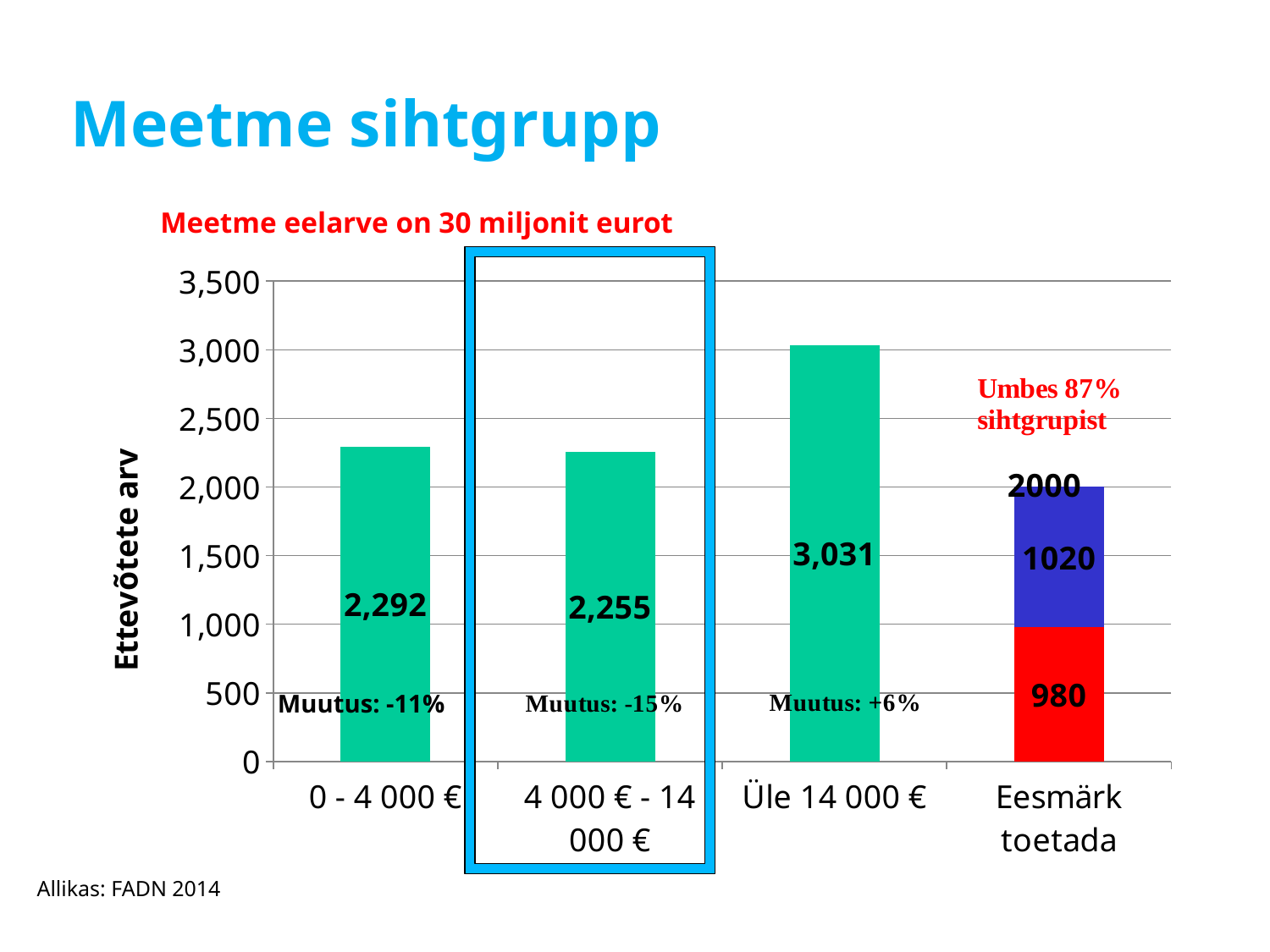
Which is larger, the value for "Üle 14 000 €" or the value for "4 000 € - 14 000 €"? Üle 14 000 € What is the total of the stacked "Eesmärk toetada" bar? 2000 What kind of chart is shown on the slide? Bar chart What is the value for the "Üle 14 000 €" category? 3,031 What is the value for the "0 - 4 000 €" category? 2,292 What is the value of the red (bottom) segment of the "Eesmärk toetada" bar? 980 What is the value of the blue (top) segment of the "Eesmärk toetada" bar? 1020 How many categories are shown on the x axis? 4 What is the value for the "4 000 € - 14 000 €" category? 2,255 Which category has the highest value? Üle 14 000 € What is the difference between the values for "Üle 14 000 €" and "0 - 4 000 €"? 739 What is the difference between the values for "0 - 4 000 €" and "4 000 € - 14 000 €"? 37